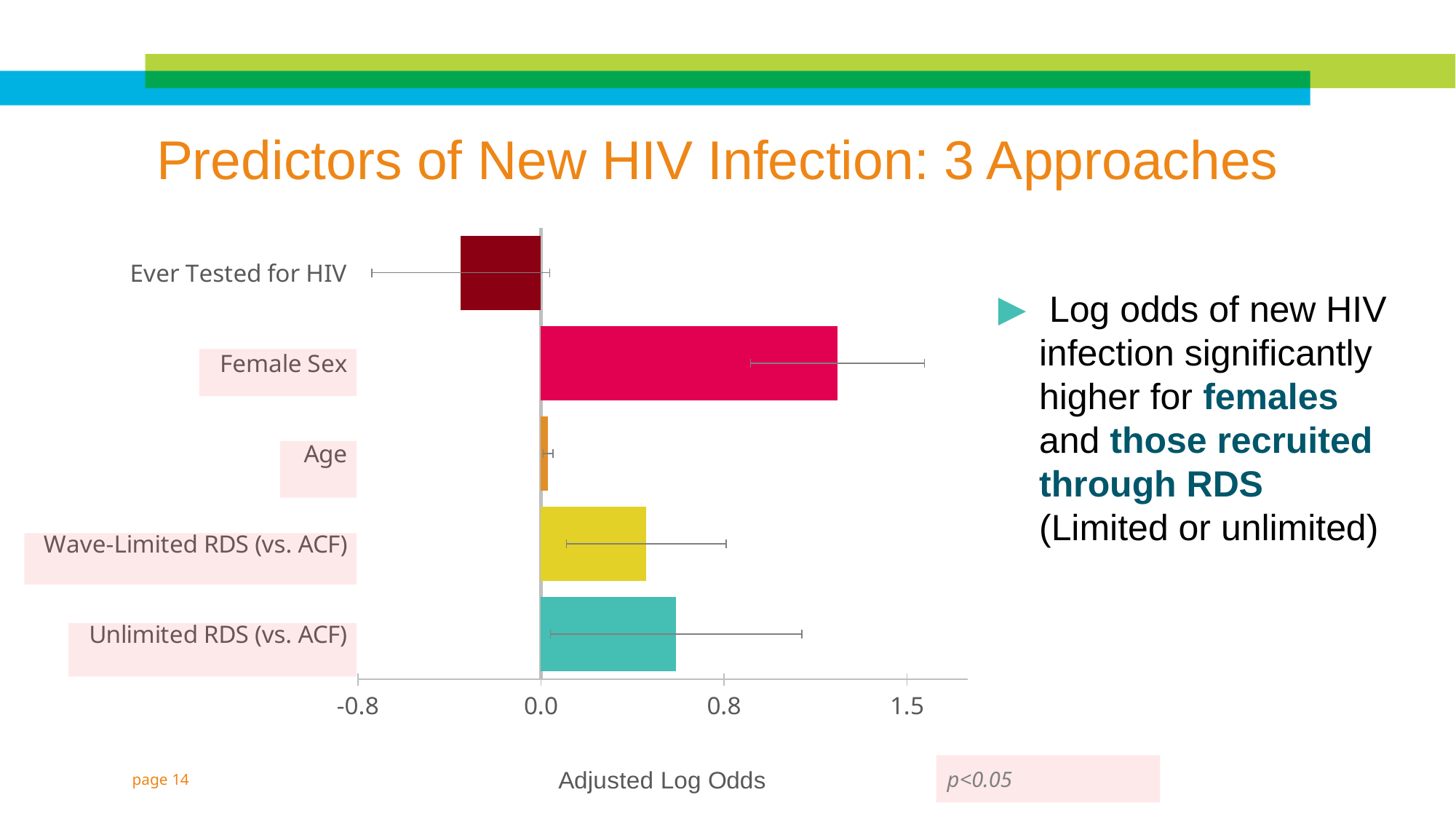
Is the adjusted log odds for Unlimited RDS (vs. ACF) greater or less than 0.8? less What is the label of the horizontal axis of the chart? Adjusted Log Odds Which category has the lowest adjusted log odds? Ever Tested for HIV Is the adjusted log odds for Wave-Limited RDS (vs. ACF) greater or less than 0.8? less Is the adjusted log odds for Female Sex greater or less than 0.8? greater Which category has the highest adjusted log odds? Female Sex How many categories are plotted in the chart? 5 What kind of chart is shown on the slide? bar chart Which category is the only one with a negative adjusted log odds? Ever Tested for HIV Which has the larger adjusted log odds, Female Sex or Unlimited RDS (vs. ACF)? Female Sex Which has the larger adjusted log odds, Unlimited RDS (vs. ACF) or Wave-Limited RDS (vs. ACF)? Unlimited RDS (vs. ACF)